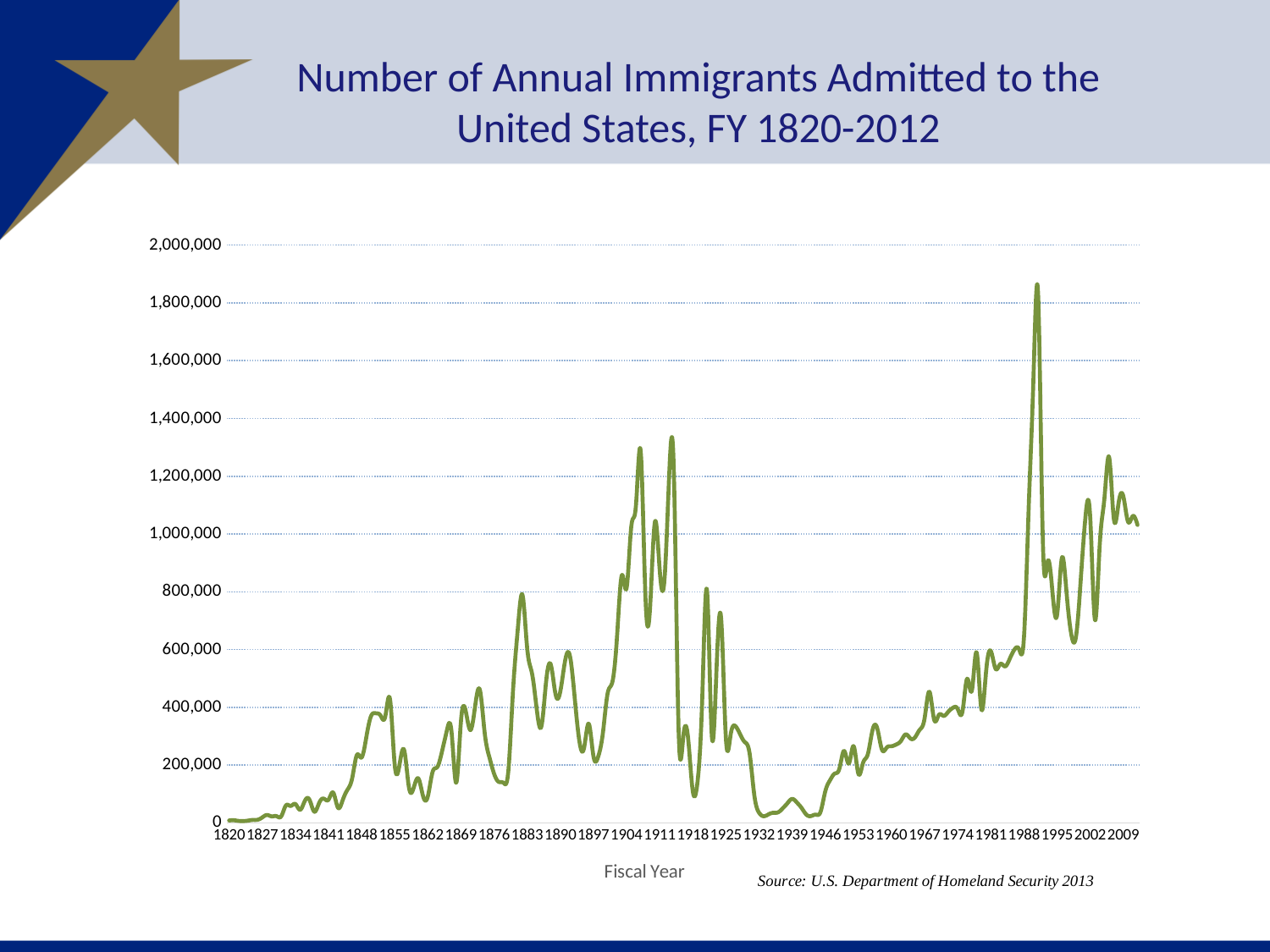
Is the value for 1932 greater or less than 200,000? less Is the value for 1967 greater or less than 600,000? less Do the values generally rise or fall between 1820 and 1855? rise What is the title of the chart? Number of Annual Immigrants Admitted to the United States, FY 1820-2012 Is the value for 1946 greater or less than 200,000? less What kind of chart is shown on the slide? line chart What is the label of the x axis? Fiscal Year Do the values generally rise or fall between 1925 and 1932? fall